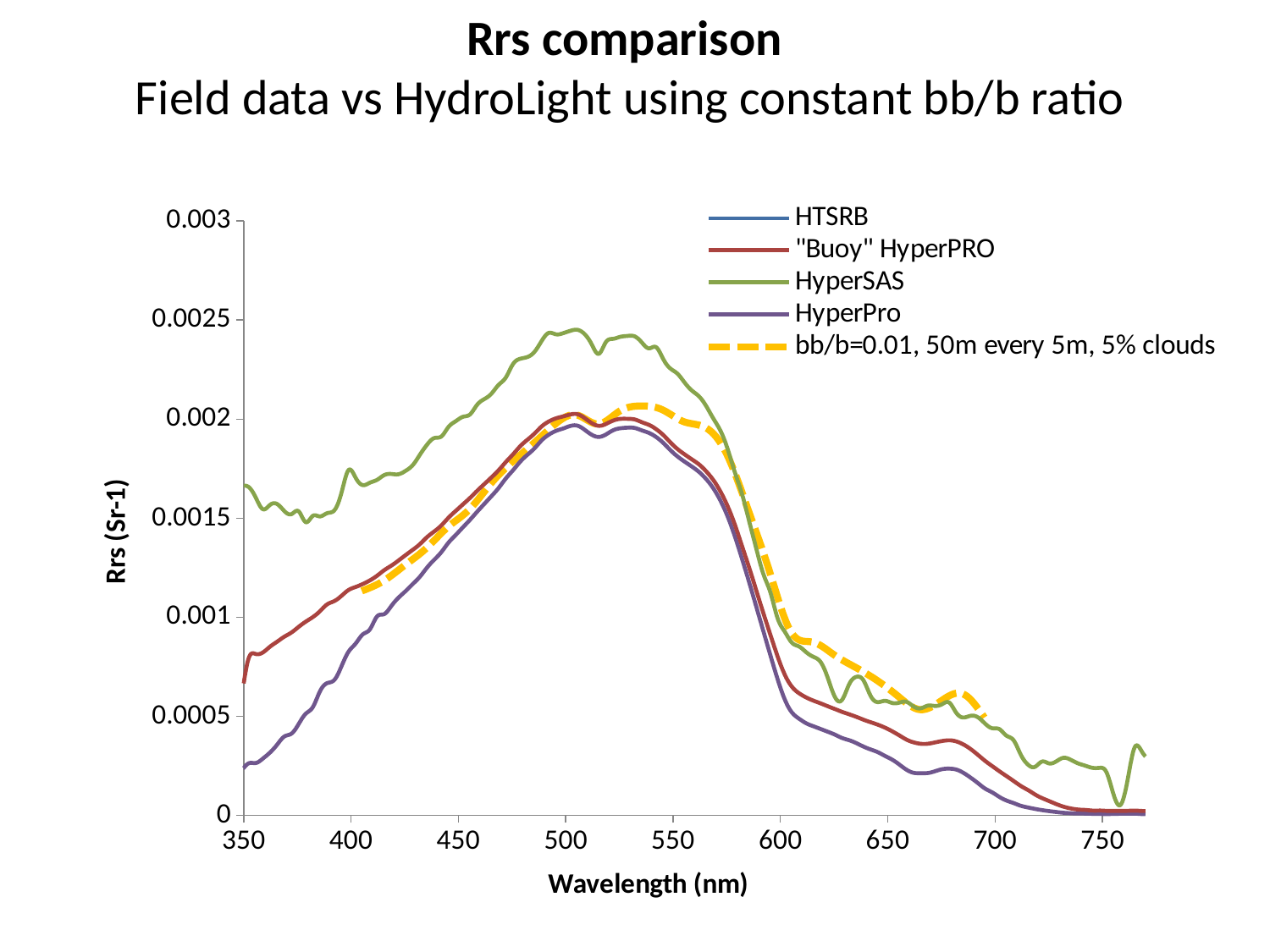
What is the label of the y axis? Rrs (Sr-1) Does the HyperPro series rise or fall between 350 nm and 500 nm? rise What kind of chart is shown on the slide? line chart Which series in the legend is drawn as a dashed line? bb/b=0.01, 50m every 5m, 5% clouds Is the value of the bb/b=0.01, 50m every 5m, 5% clouds series at 650 nm greater or less than 0.001? less Which series has the lowest value at 350 nm? HyperPro Is the HyperSAS value at 500 nm greater or less than 0.002? greater Which series has the highest value at 500 nm? HyperSAS Is the HyperSAS value at 350 nm greater or less than 0.0015? greater At 450 nm, which is larger: HyperSAS or HyperPro? HyperSAS How many series does the legend list? 5